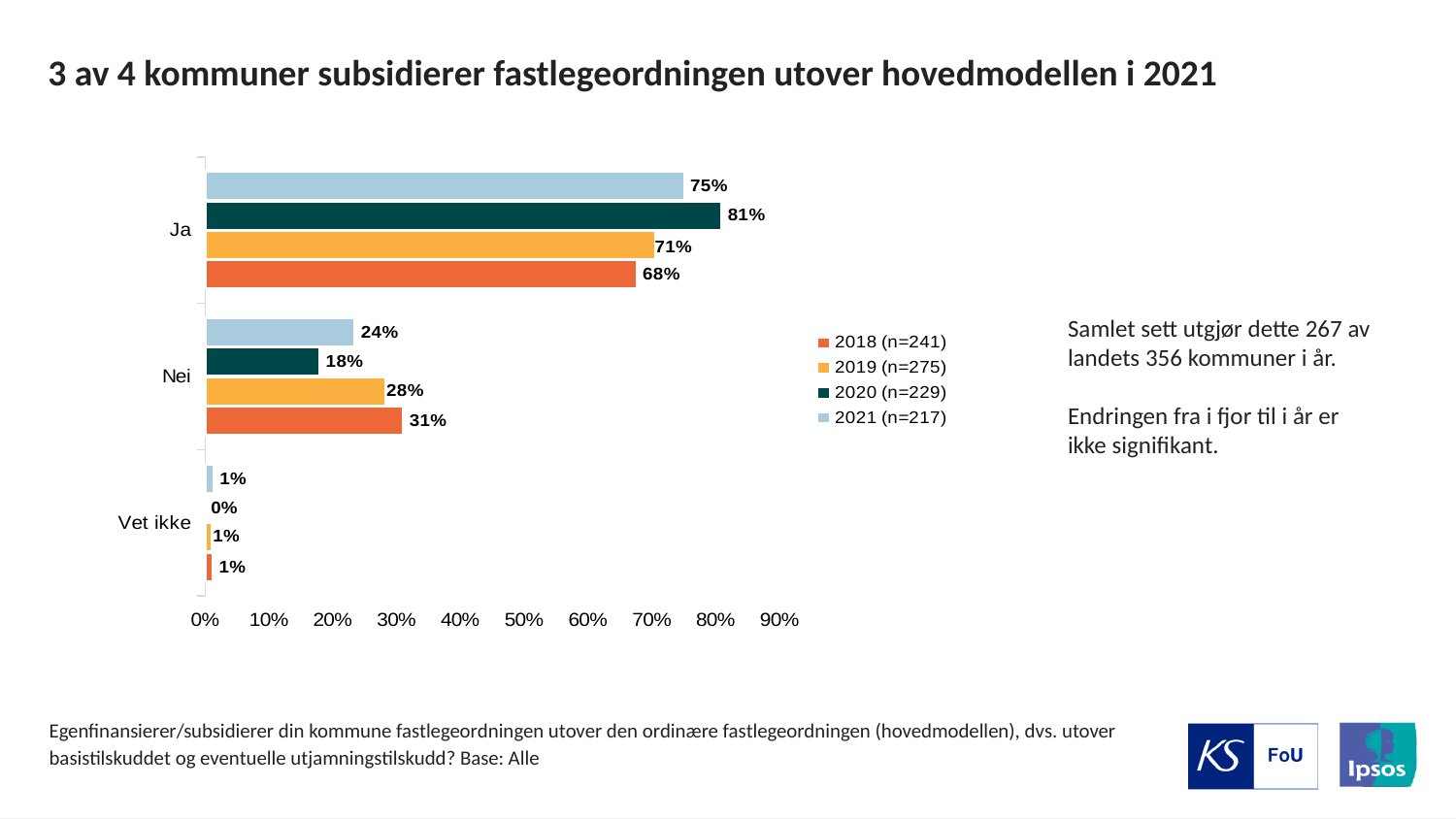
In which year's series is the value for "Nei" lowest? 2020 (n=229) What is the title of the slide? 3 av 4 kommuner subsidierer fastlegeordningen utover hovedmodellen i 2021 What is the difference between the "Ja" values for 2020 (n=229) and 2021 (n=217)? 6 percentage points How many categories are shown on the vertical axis? 3 What kind of chart is shown on the slide? Bar chart Which is larger: the "Nei" value for 2019 (n=275) or for 2021 (n=217)? 2019 (n=275) In which year's series is the value for "Ja" highest? 2020 (n=229) What is the value for "Ja" in the 2021 (n=217) series? 75% What is the value for "Nei" in the 2020 (n=229) series? 18% What is the value for "Nei" in the 2018 (n=241) series? 31% What is the value for "Vet ikke" in the 2020 (n=229) series? 0% How many series does the legend list? 4